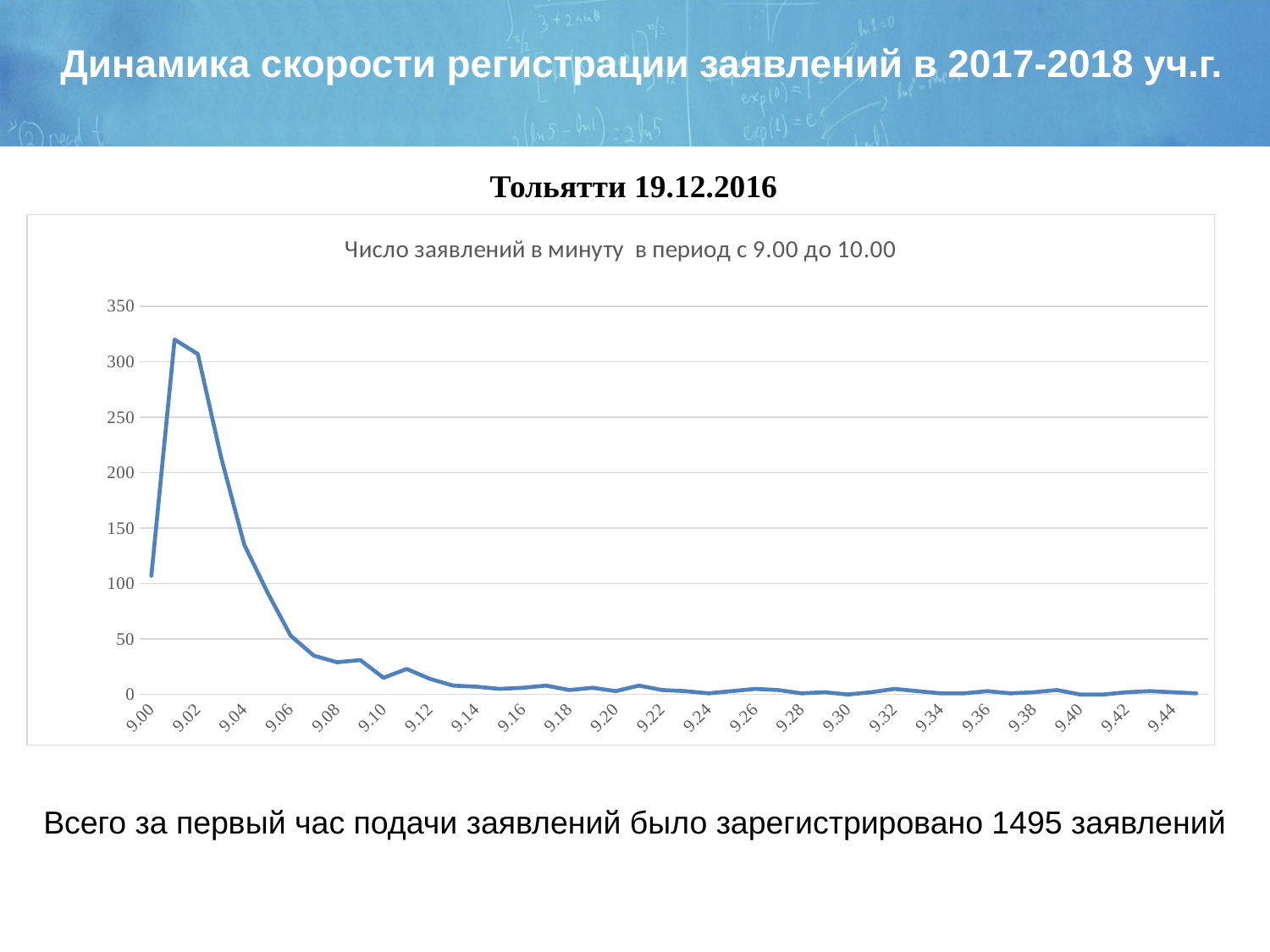
Which has the larger value, 9.04 or 9.08? 9.04 Is the value at 9.02 greater or less than 300? greater Is the value at 9.00 greater or less than 100? greater Which has the larger value, 9.00 or 9.02? 9.02 Is the peak value of the line greater or less than 350? less What kind of chart is shown on the slide? line chart Do the values rise or fall along the x axis from 9.02 to 9.10? fall What is the title of the chart? Число заявлений в минуту в период с 9.00 до 10.00 What is the highest value shown on the vertical axis of the chart? 350